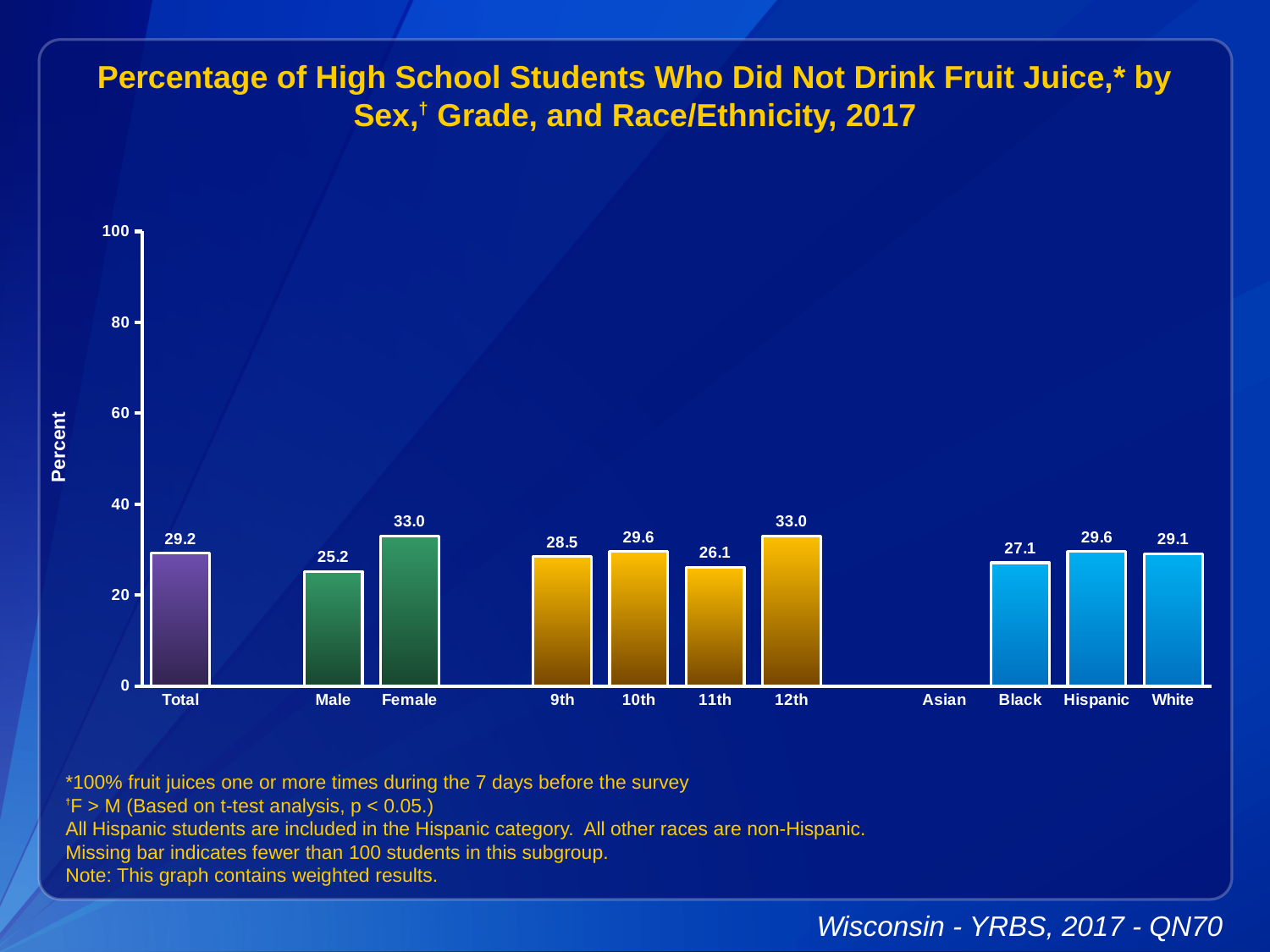
Which is larger, the value for Hispanic or the value for White? Hispanic What percentage of female students did not drink fruit juice? 33.0 Which category on the x axis has no bar plotted? Asian What is the value for Total? 29.2 What is the value for Black students? 27.1 What is the difference between the Female and Male values? 7.8 What is the value for 11th grade? 26.1 Is the value for 12th grade greater or less than 40? less What type of chart is shown on the slide? bar chart How many bars are plotted on the chart? 10 Among the grade categories (9th, 10th, 11th, 12th), which has the highest value? 12th Which category has the lowest value on the chart? Male